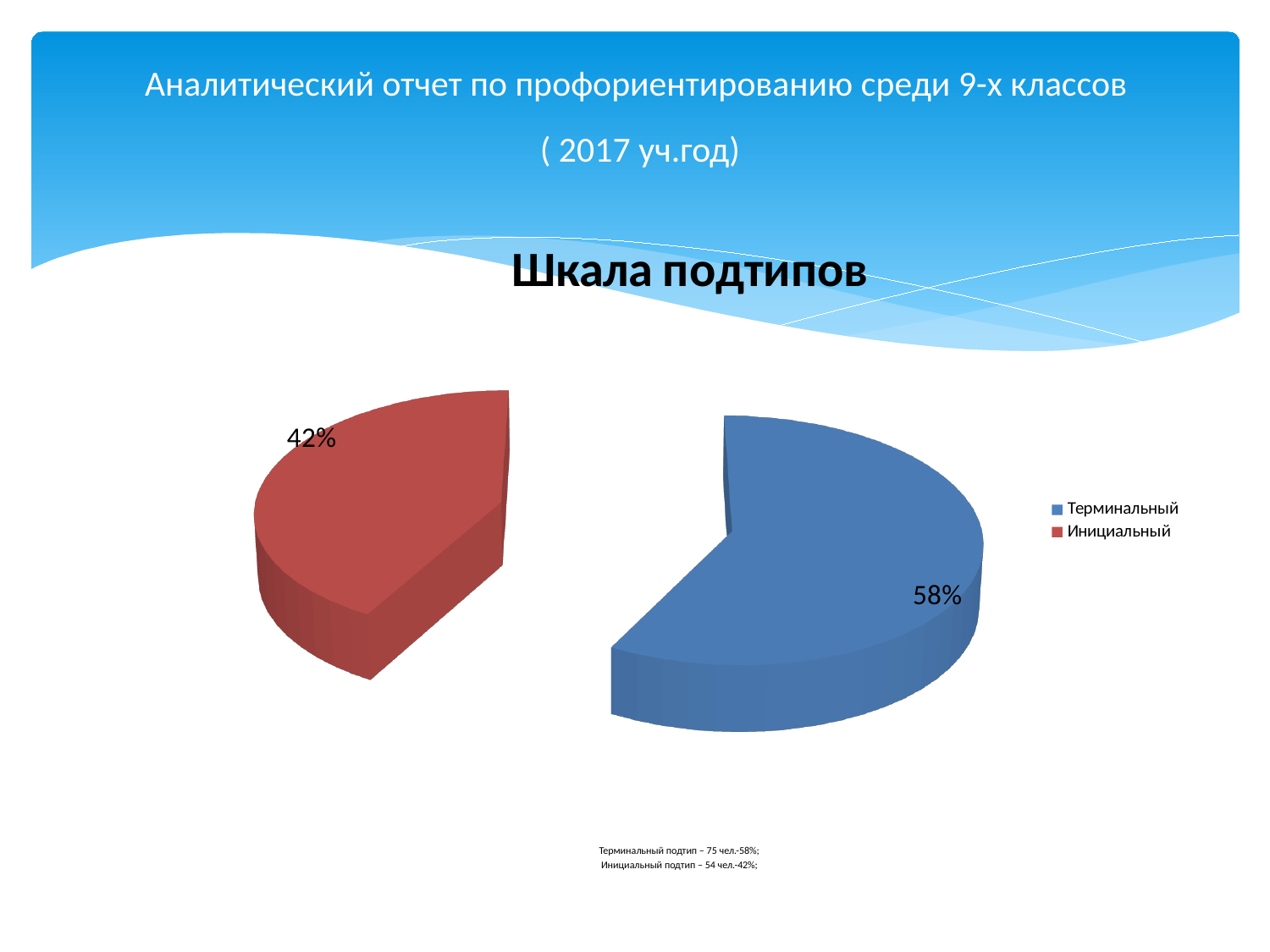
What type of chart is shown on the slide? pie chart Which category has the largest share of the pie? Терминальный How many slices does the pie chart have? 2 Which category has the smallest share of the pie? Инициальный What percentage is shown for Терминальный? 58% Which is larger, the share for Терминальный or for Инициальный? Терминальный What percentage is shown for Инициальный? 42% What is the difference in percentage points between Терминальный and Инициальный? 16 How many entries does the legend list? 2 Is the share for Терминальный greater or less than 50%? greater What colour is the slice for Инициальный? red What is the title of the chart? Шкала подтипов